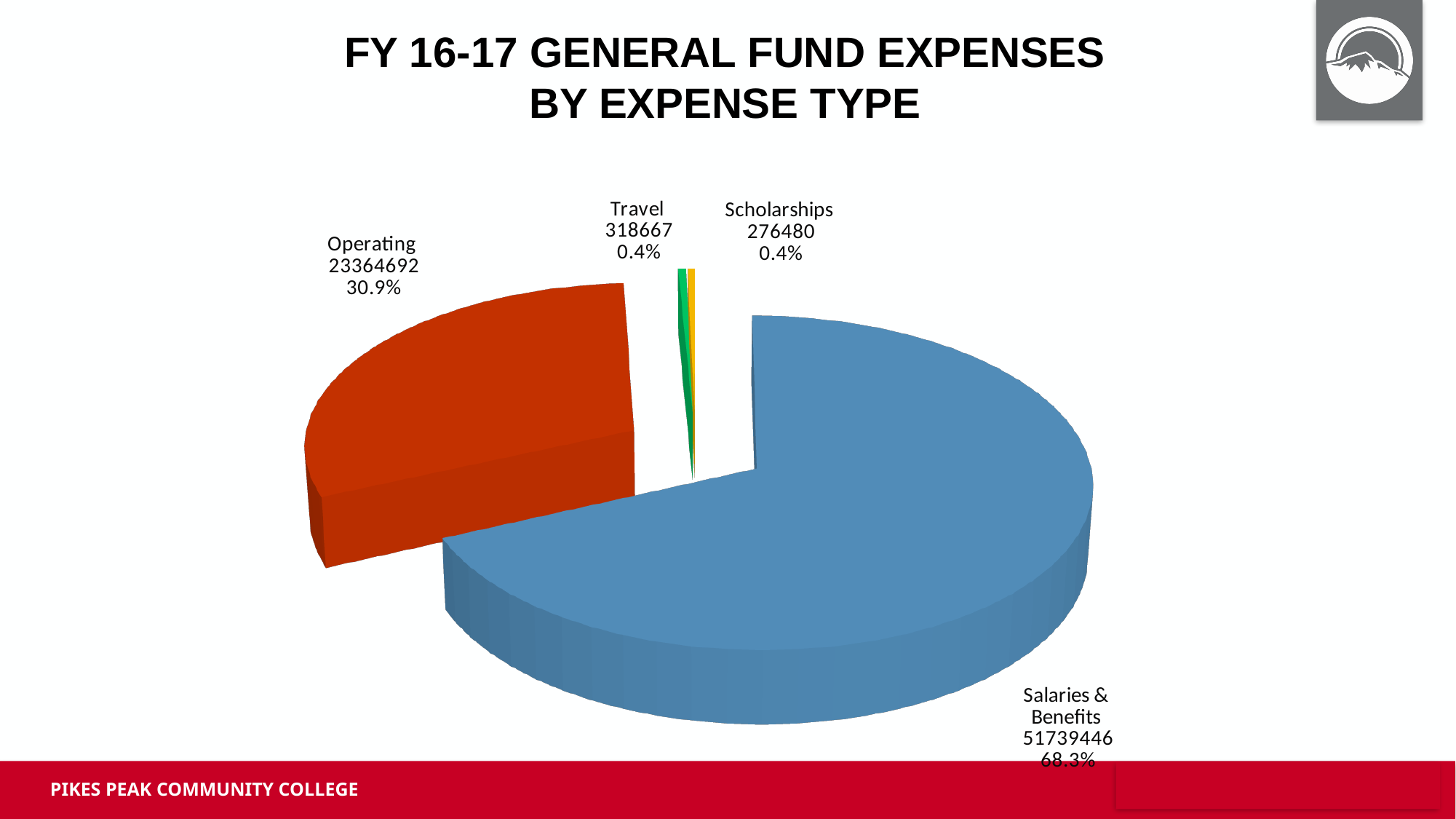
What is the difference between Salaries & Benefits and Operating? 28374754 Which is larger, Operating or Salaries & Benefits? Salaries & Benefits What percentage share does Salaries & Benefits have? 68.3% What is the value for Travel? 318667 Which expense type has the largest slice? Salaries & Benefits What is the difference between Travel and Scholarships? 42187 What is the value for Scholarships? 276480 What is the title of the chart? FY 16-17 GENERAL FUND EXPENSES BY EXPENSE TYPE What is the value for Operating? 23364692 How many expense types are shown in the pie chart? 4 What kind of chart is shown on the slide? Pie chart Which expense type has the smallest value? Scholarships